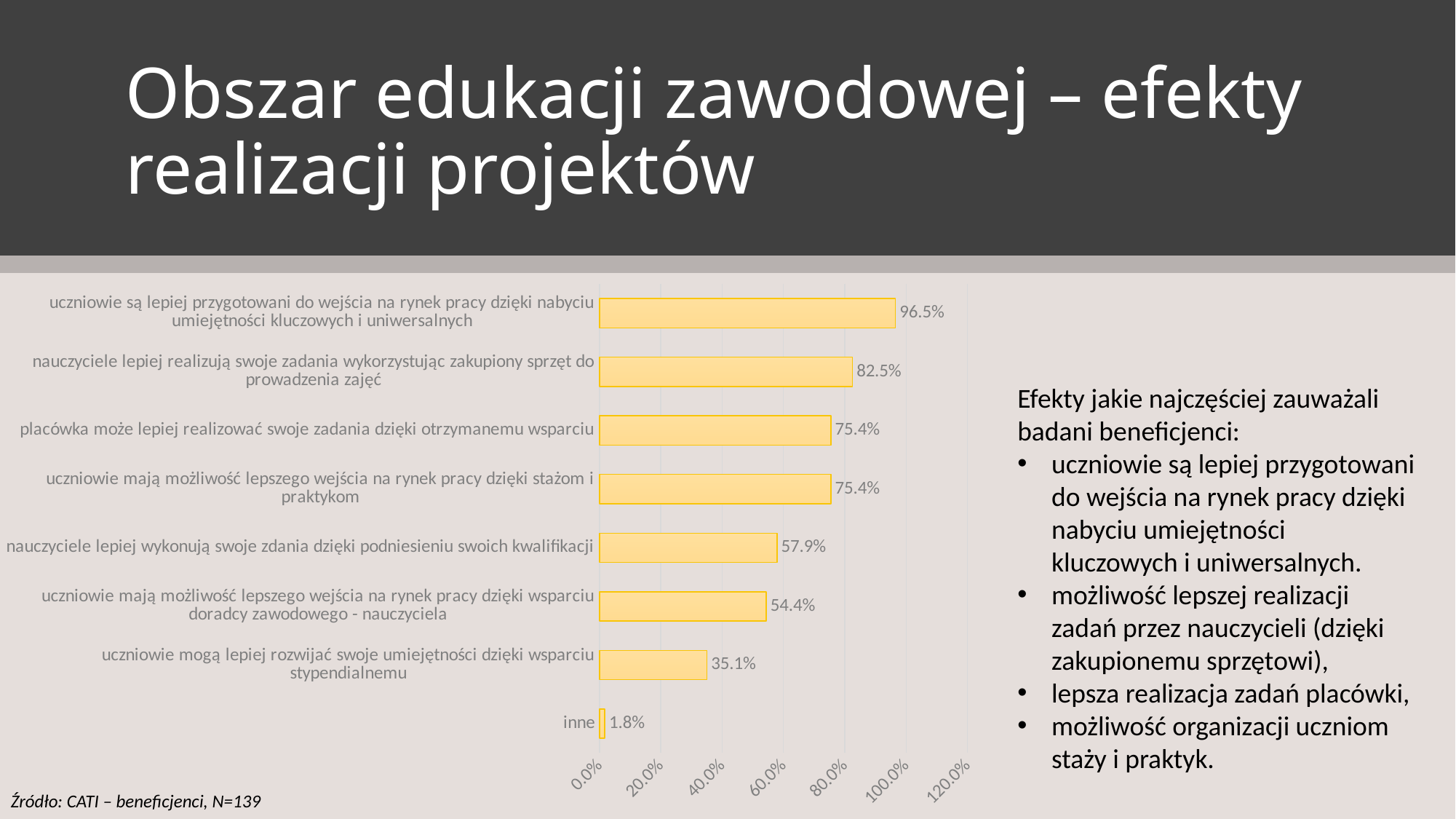
How many categories are shown in the chart? 8 Which category has the lowest value? inne Which category has the highest value? uczniowie są lepiej przygotowani do wejścia na rynek pracy dzięki nabyciu umiejętności kluczowych i uniwersalnych What is the value for 'nauczyciele lepiej realizują swoje zadania wykorzystując zakupiony sprzęt do prowadzenia zajęć'? 82.5% What is the difference between the values for 'nauczyciele lepiej wykonują swoje zdania dzięki podniesieniu swoich kwalifikacji' and 'uczniowie mają możliwość lepszego wejścia na rynek pracy dzięki wsparciu doradcy zawodowego - nauczyciela'? 3.5% Which is larger: the value for 'placówka może lepiej realizować swoje zadania dzięki otrzymanemu wsparciu' or the value for 'nauczyciele lepiej wykonują swoje zdania dzięki podniesieniu swoich kwalifikacji'? placówka może lepiej realizować swoje zadania dzięki otrzymanemu wsparciu What kind of chart is shown on the slide? bar chart What is the value for 'inne'? 1.8% Is the value for 'uczniowie mogą lepiej rozwijać swoje umiejętności dzięki wsparciu stypendialnemu' greater or less than 40.0%? less What is the difference between the highest value and the value for 'inne'? 94.7% What is the value for 'uczniowie mogą lepiej rozwijać swoje umiejętności dzięki wsparciu stypendialnemu'? 35.1% What is the source given below the chart? CATI – beneficjenci, N=139